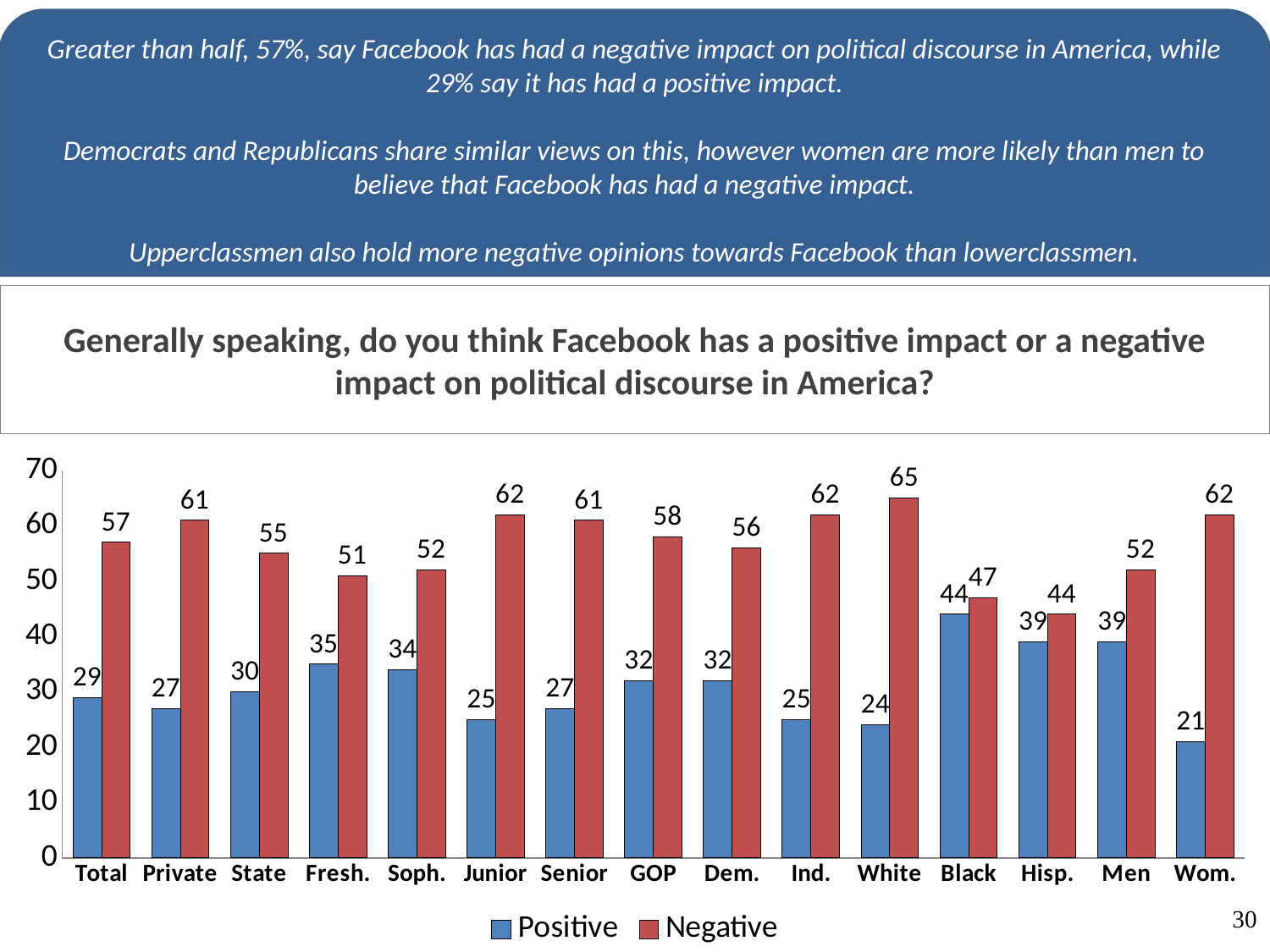
What kind of chart is shown on the slide? bar chart What is the difference between the Negative and Positive values for Wom.? 41 What is the Negative value for White? 65 Which series is shown in red? Negative How many categories are shown on the x axis? 15 Which category has the lowest Positive value? Wom. Which category has the highest Negative value? White What is the Negative value for Total? 57 Is the Negative value for Black greater or less than 50? less Which is larger, the Positive value for Black or the Positive value for Hisp.? Black How many series does the legend list? 2 What is the Positive value for Fresh.? 35